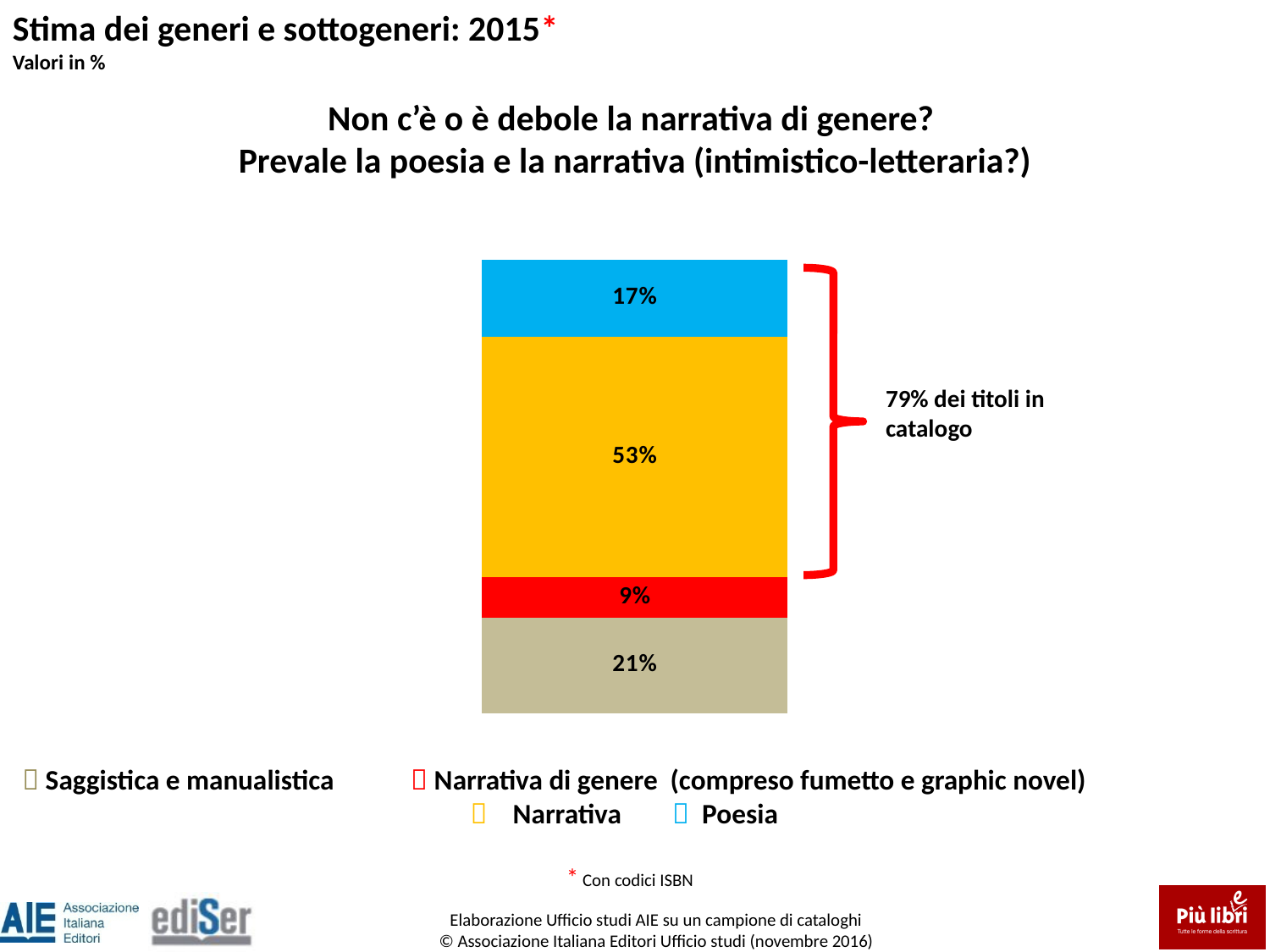
What kind of chart is shown on the slide? Stacked bar chart What percentage is shown for Saggistica e manualistica? 21% What percentage is shown for Narrativa di genere (compreso fumetto e graphic novel)? 9% What percentage is shown for Poesia in the stacked bar? 17% What percentage is shown for Narrativa in the stacked bar? 53% Which is larger, the share for Saggistica e manualistica or the share for Poesia? Saggistica e manualistica Which genre has the largest share in the stacked bar? Narrativa What is the difference in percentage points between Narrativa and Poesia? 36 How many segments make up the stacked bar? 4 What is the combined share of Narrativa and Poesia, as indicated by the bracket on the chart? 70% What does the red bracket next to the bar say the 79% refers to? 79% dei titoli in catalogo Which genre has the smallest share in the stacked bar? Narrativa di genere (compreso fumetto e graphic novel)